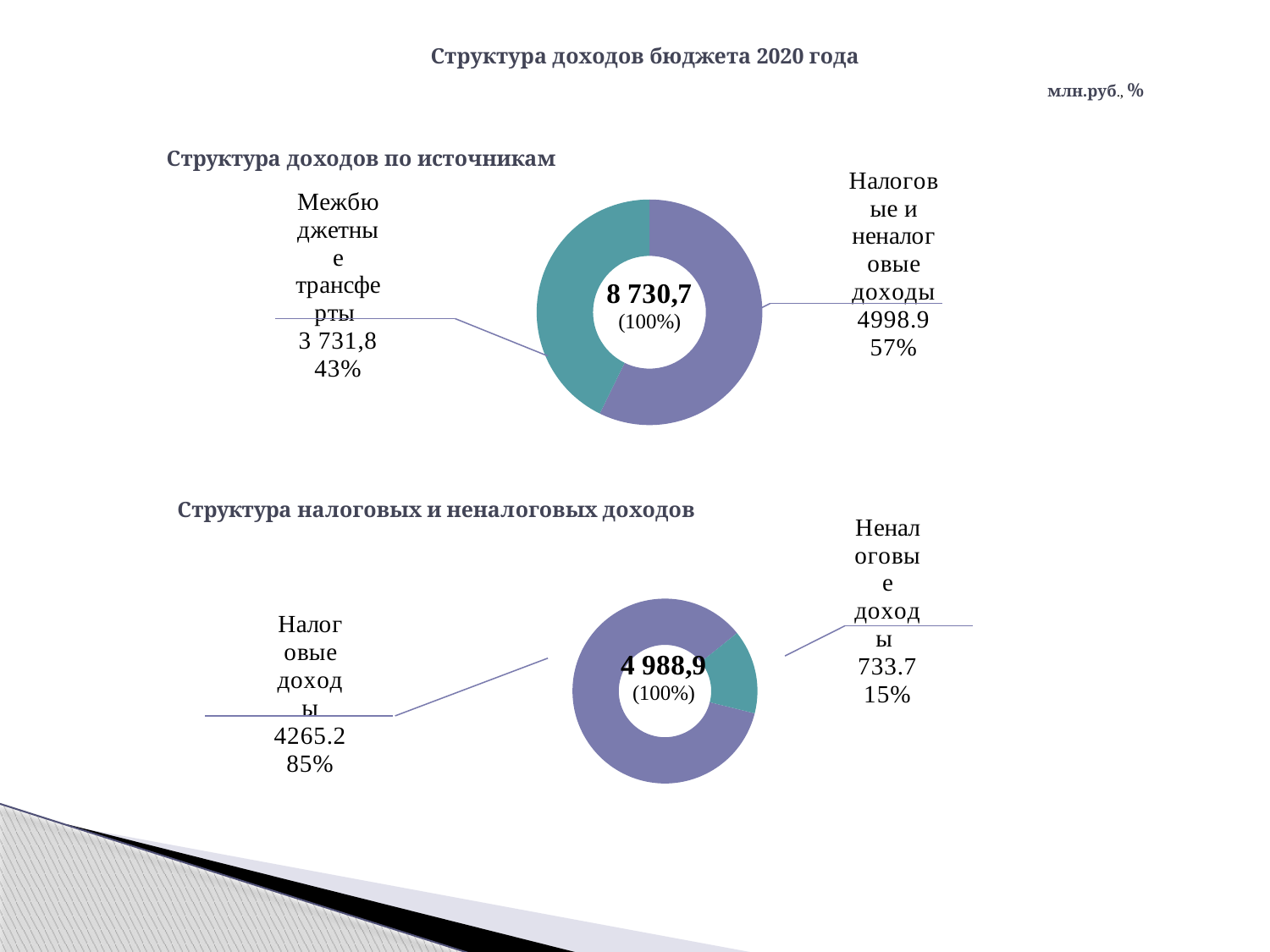
What kind of chart is used for 'Структура налоговых и неналоговых доходов'? Doughnut (pie) chart In the chart 'Структура налоговых и неналоговых доходов', what is the value for Неналоговые доходы? 733.7 In the chart 'Структура доходов по источникам', which category is the largest? Налоговые и неналоговые доходы In the chart 'Структура налоговых и неналоговых доходов', what total is shown in the centre of the doughnut? 4 988,9 In the chart 'Структура налоговых и неналоговых доходов', which category is the smallest? Неналоговые доходы In the chart 'Структура доходов по источникам', what total is shown in the centre of the doughnut? 8 730,7 In the chart 'Структура доходов по источникам', how many categories are shown? 2 In the chart 'Структура доходов по источникам', what share of the total do Налоговые и неналоговые доходы make up? 57% In the chart 'Структура налоговых и неналоговых доходов', what share do Налоговые доходы make up? 85% In the chart 'Структура доходов по источникам', which colour represents Межбюджетные трансферты? Teal (green) In the chart 'Структура доходов по источникам', what is the value for Межбюджетные трансферты? 3 731,8